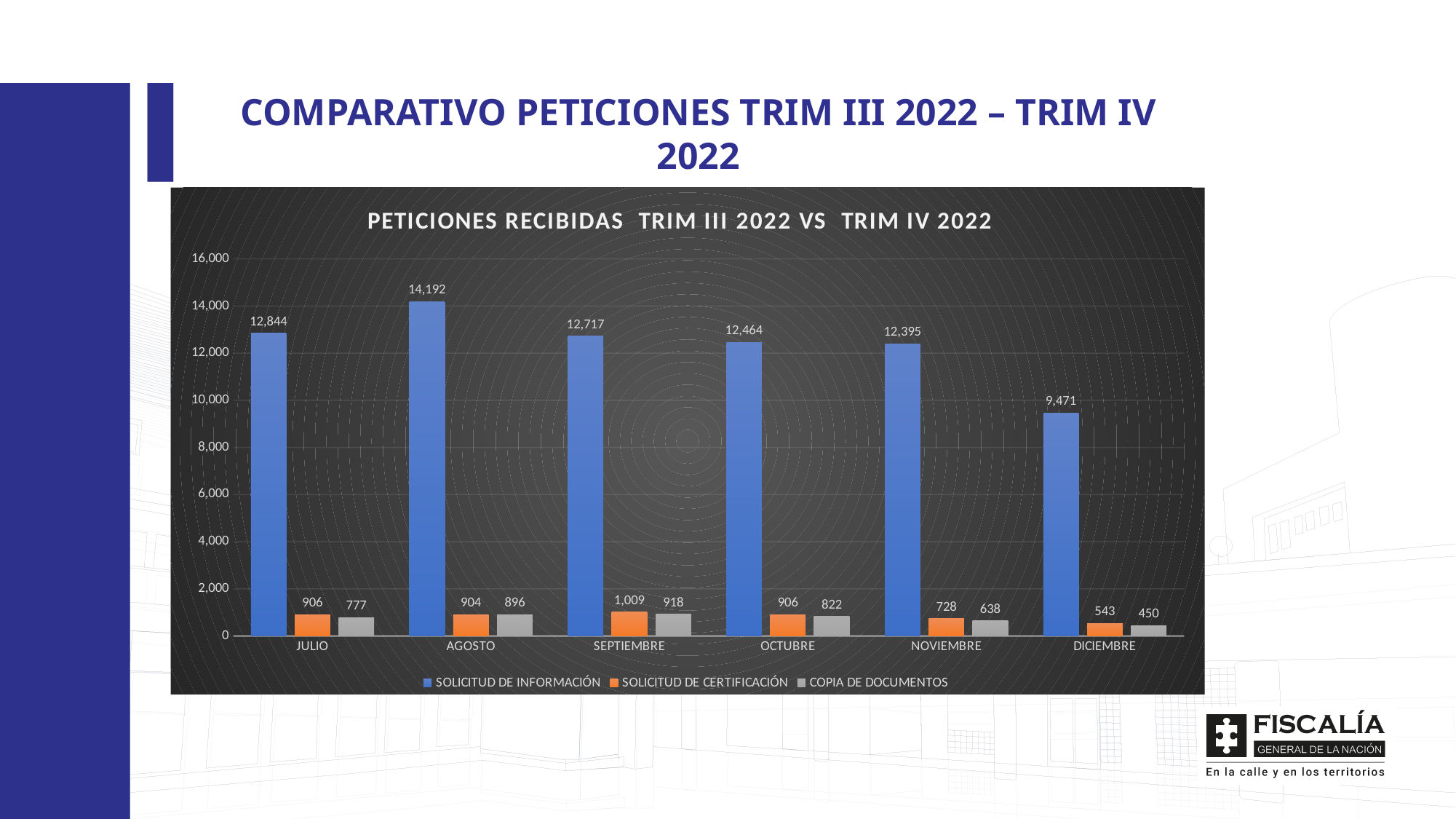
What kind of chart is shown? bar chart What is the difference between SOLICITUD DE INFORMACIÓN in JULIO and in DICIEMBRE? 3,373 Which month has the lowest value for COPIA DE DOCUMENTOS? DICIEMBRE What is the value of SOLICITUD DE INFORMACIÓN for AGOSTO? 14,192 What is the title of the chart? PETICIONES RECIBIDAS TRIM III 2022 VS TRIM IV 2022 What is the value of SOLICITUD DE CERTIFICACIÓN for NOVIEMBRE? 728 How many series does the legend list? 3 What is the value of COPIA DE DOCUMENTOS for SEPTIEMBRE? 918 How many months are shown on the x axis? 6 Which is larger: SOLICITUD DE CERTIFICACIÓN in SEPTIEMBRE or in OCTUBRE? SEPTIEMBRE Which month has the highest value for SOLICITUD DE INFORMACIÓN? AGOSTO Is the value of SOLICITUD DE INFORMACIÓN for DICIEMBRE greater or less than 10,000? less